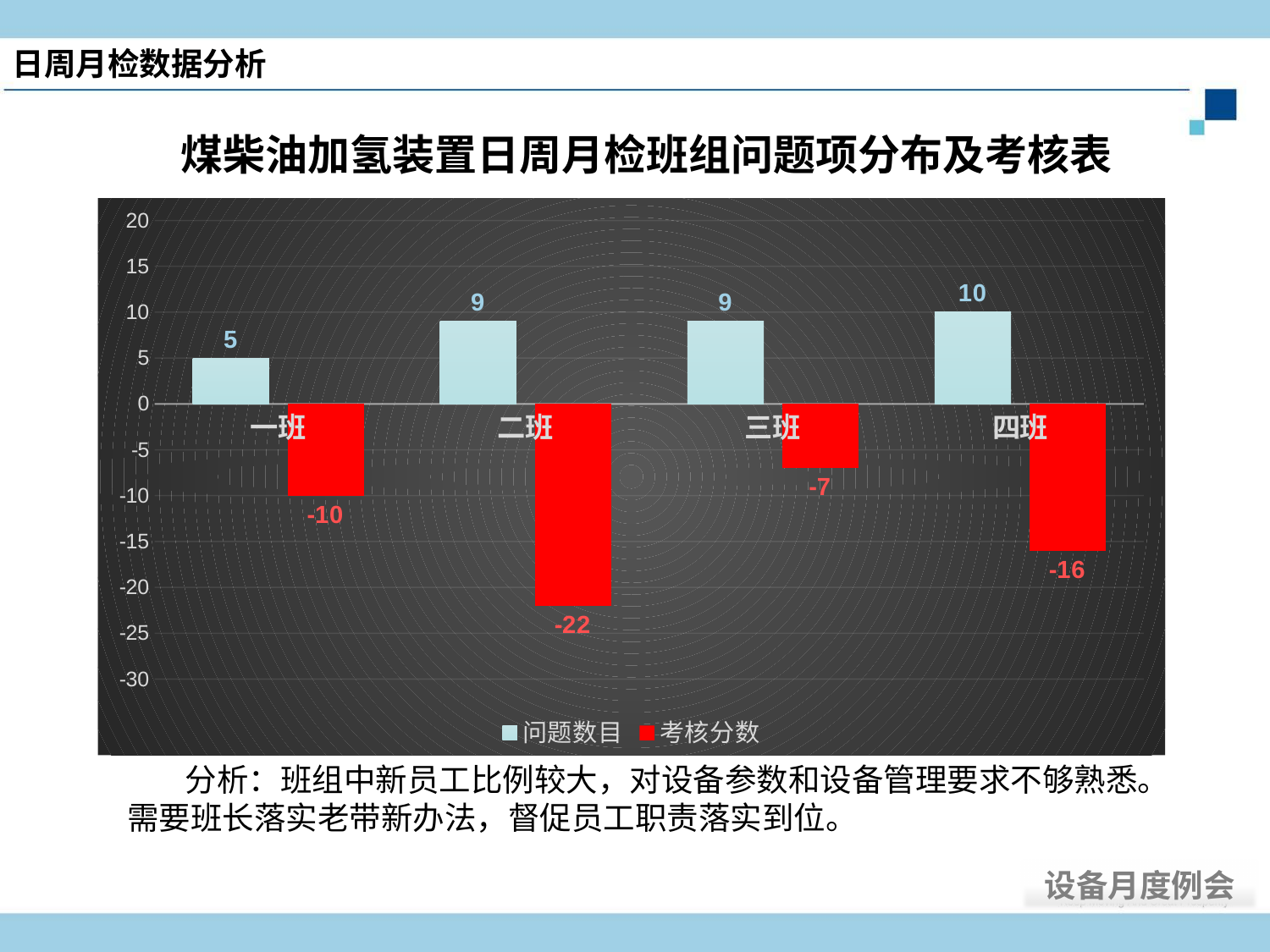
How many series does the legend list? 2 What kind of chart is shown on the slide? bar chart What colour are the 考核分数 bars? red What is the 考核分数 value for 一班? -10 What is the 考核分数 value for 四班? -16 Is the 考核分数 value for 二班 greater or less than -20? less What is the difference between the 问题数目 values for 四班 and 一班? 5 Which category has the highest 问题数目 value? 四班 Which category has the lowest 考核分数 value? 二班 What is the 问题数目 value for 二班? 9 How many categories are shown on the x axis? 4 Which has a larger 问题数目 value, 一班 or 三班? 三班